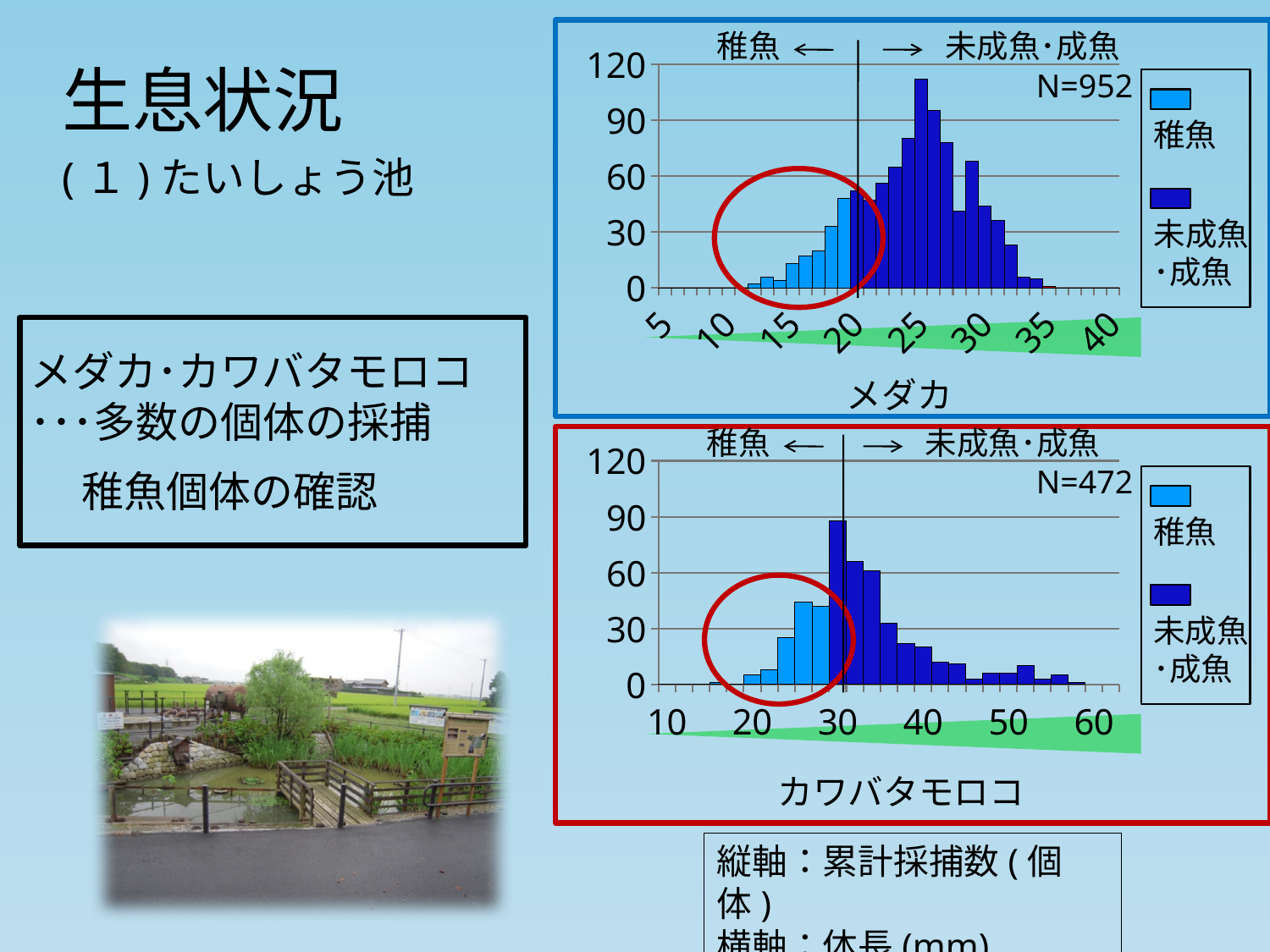
In the カワバタモロコ chart, do the bar heights rise or fall along the x axis from 30 to 60? fall What kind of chart is the bottom chart titled カワバタモロコ? bar chart In the カワバタモロコ chart, how many series does the legend list? 2 In the カワバタモロコ chart, what sample size N is printed on the chart? N=472 In the カワバタモロコ chart, is the tallest light-blue (稚魚) bar greater or less than 30? greater In the メダカ chart, how many series does the legend list? 2 In the メダカ chart, is the tallest light-blue (稚魚) bar greater or less than 60? less In the メダカ chart, is the tallest bar greater or less than 90? greater In the メダカ chart, what sample size N is printed on the chart? N=952 What kind of chart is the top chart titled メダカ? bar chart In the メダカ chart, which series is shown in dark blue? 未成魚・成魚